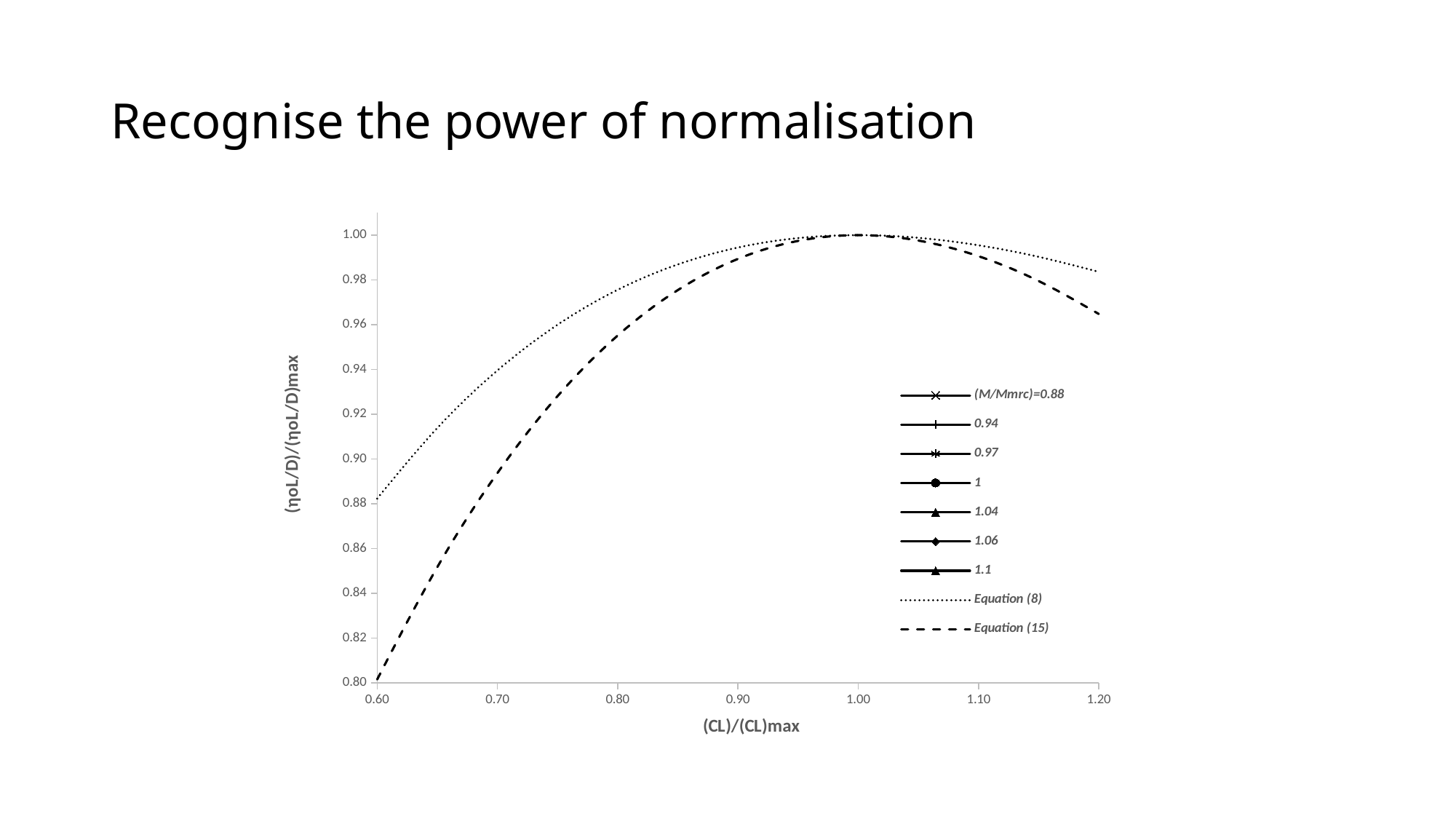
At (CL)/(CL)max = 1.20, is the value of the Equation (15) curve greater or less than 0.98? less At which value of (CL)/(CL)max do the Equation (8) and Equation (15) curves reach their maximum? 1.00 Does the Equation (15) curve rise or fall as (CL)/(CL)max increases from 0.60 to 1.00? rise What kind of chart is shown on the slide? line chart At (CL)/(CL)max = 0.80, which curve has the higher value, Equation (8) or Equation (15)? Equation (8) What is the maximum value reached by the Equation (15) curve? 1.00 Which line style is used for the Equation (8) series in the legend? dotted How many series does the legend list? 9 What is the label of the x axis? (CL)/(CL)max At (CL)/(CL)max = 0.70, is the value of the Equation (8) curve greater or less than 0.92? greater